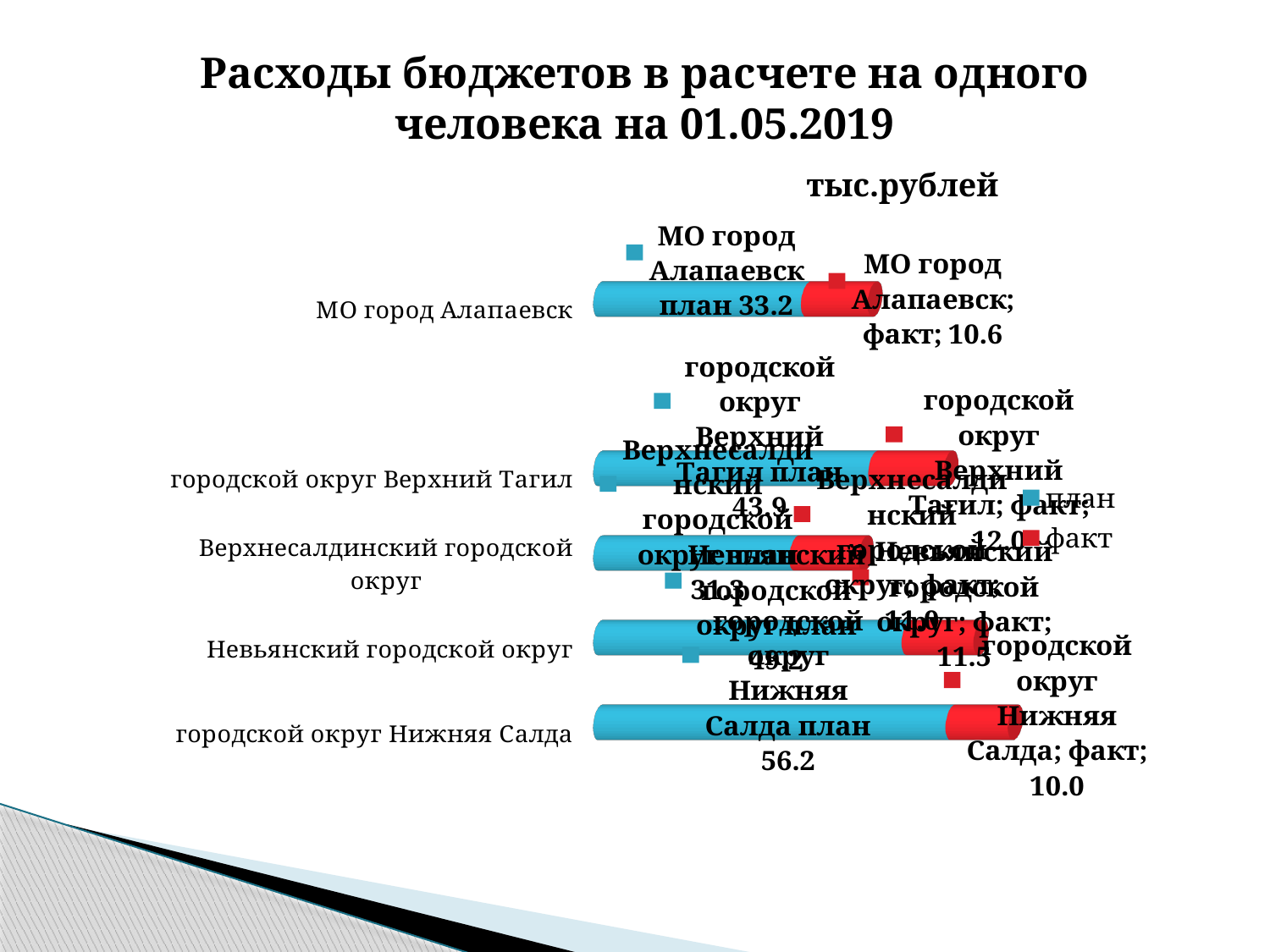
How many municipalities (categories) are plotted in the chart? 5 What kind of chart is shown on the slide? bar chart What is the факт value for городской округ Нижняя Салда? 10.0 What is the total of план and факт for городской округ Нижняя Салда? 66.2 What is the факт value for МО город Алапаевск? 10.6 What is the план value for МО город Алапаевск? 33.2 What unit is stated above the chart? тыс.рублей Which municipality has the highest план value? городской округ Нижняя Салда What is the план value for городской округ Верхний Тагил? 43.9 What is the план value for городской округ Нижняя Салда? 56.2 What is the difference between the план and факт values for МО город Алапаевск? 22.6 How many series does the legend list? 2